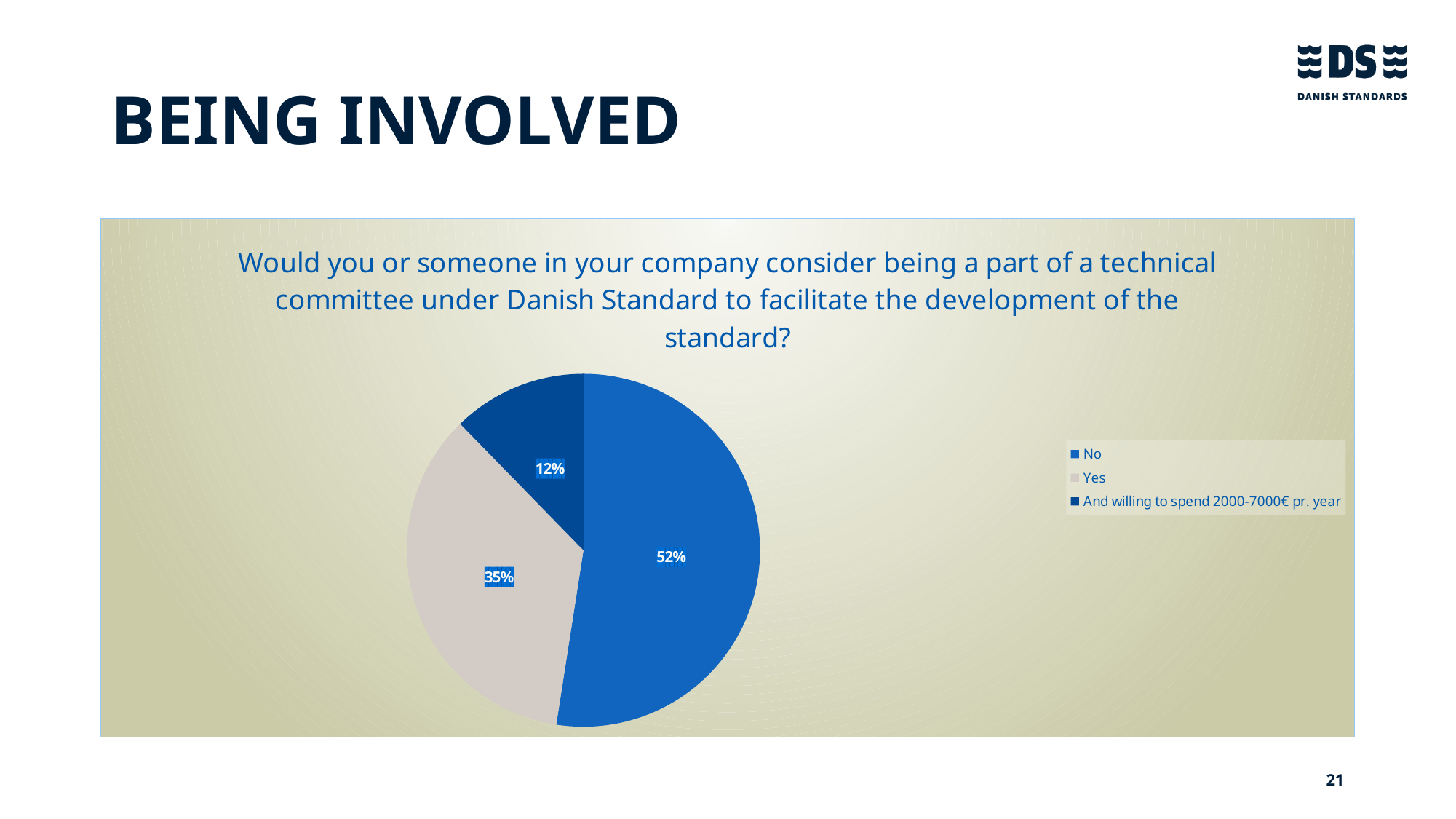
Which response has the largest slice of the pie? No What percentage of respondents answered "No"? 52% How many slices does the pie chart have? 3 How many entries does the legend list? 3 What is the difference in percentage points between the "No" and "Yes" slices? 17 What share of the pie is labelled "And willing to spend 2000-7000€ pr. year"? 12% Which response has the smallest slice of the pie? And willing to spend 2000-7000€ pr. year Which is larger, the "Yes" slice or the "No" slice? No What colour is the "Yes" slice in the pie chart? Light grey/beige What percentage of respondents answered "Yes"? 35% What kind of chart is shown on the slide? Pie chart What is the difference in percentage points between the "Yes" slice and the "And willing to spend 2000-7000€ pr. year" slice? 23